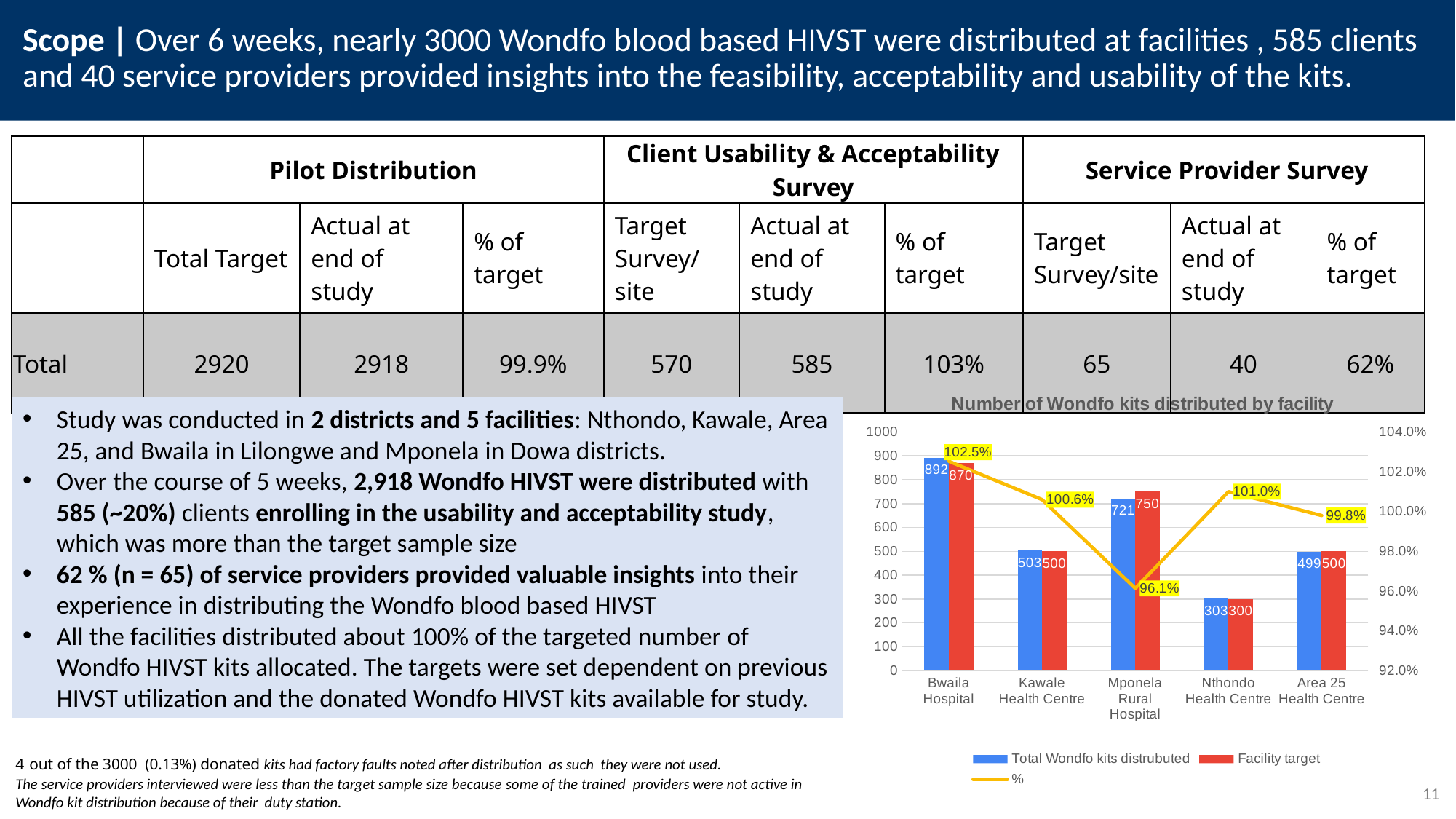
How many facilities are shown on the x axis of the chart? 5 How many series does the chart legend list? 3 What is the Facility target for Mponela Rural Hospital? 750 Which is larger for Kawale Health Centre: Total Wondfo kits distributed or Facility target? Total Wondfo kits distributed What is the value of Total Wondfo kits distributed for Bwaila Hospital? 892 Which facility has the highest number of Total Wondfo kits distributed? Bwaila Hospital Is the Total Wondfo kits distributed for Nthondo Health Centre greater or less than 400? less What is the difference between the Facility target and the Total Wondfo kits distributed for Mponela Rural Hospital? 29 What kind of chart is shown on the slide? Combined bar and line chart Which facility has the lowest % value on the line? Mponela Rural Hospital What is the title of the chart on the slide? Number of Wondfo kits distributed by facility What is the % value shown for Nthondo Health Centre? 101.0%